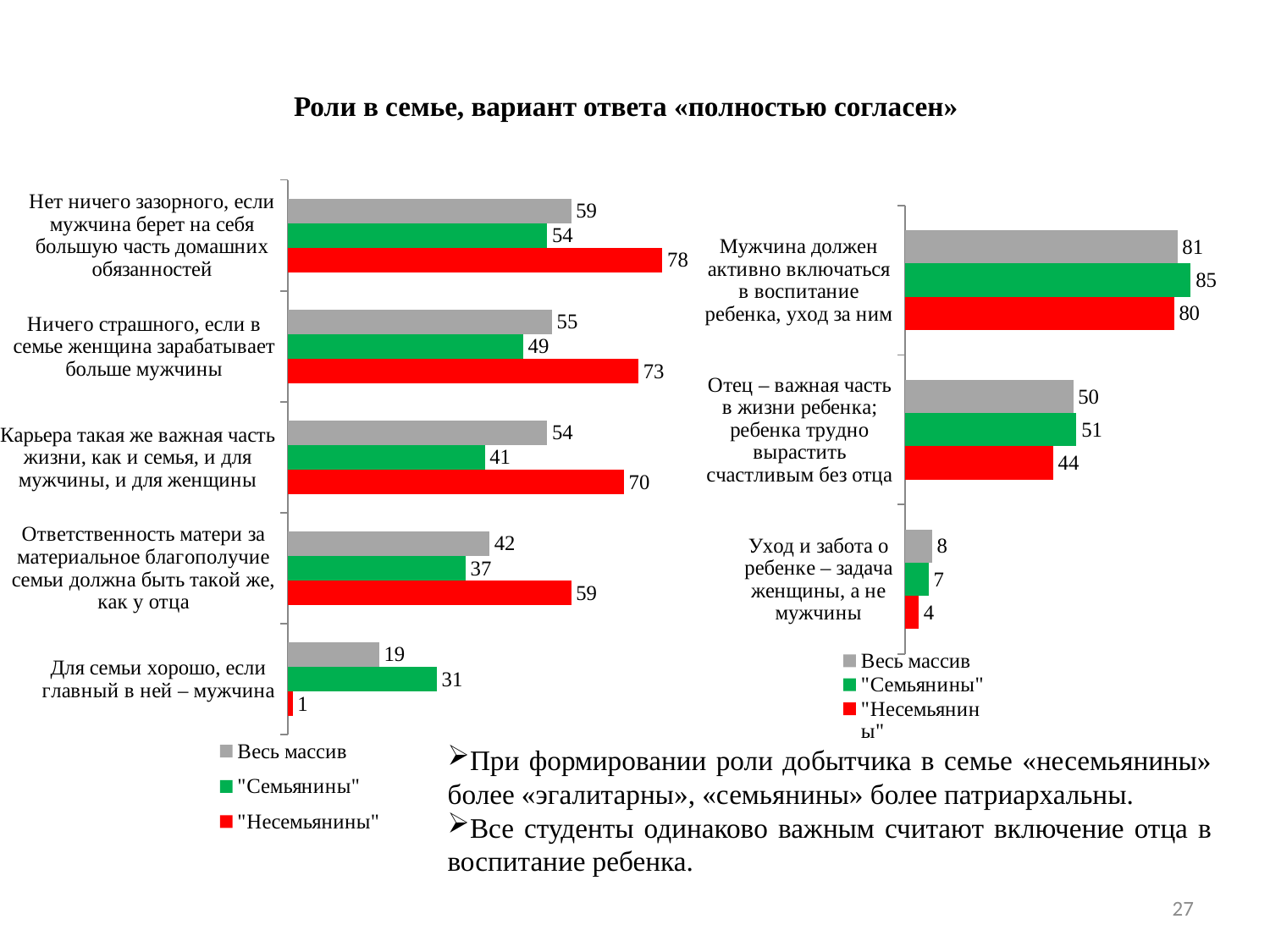
In the left chart, which category has the lowest value for "Несемьянины"? Для семьи хорошо, если главный в ней – мужчина In the left chart, what is the value for "Весь массив" for the statement "Для семьи хорошо, если главный в ней – мужчина"? 19 In the left chart, what is the value for "Несемьянины" for the statement "Нет ничего зазорного, если мужчина берет на себя большую часть домашних обязанностей"? 78 In the left chart, what is the difference between the "Несемьянины" and "Семьянины" values for "Карьера такая же важная часть жизни, как и семья, и для мужчины, и для женщины"? 29 In the left chart, which is larger for "Для семьи хорошо, если главный в ней – мужчина": the value for "Семьянины" or for "Весь массив"? "Семьянины" In the right chart, which category has the highest value for "Весь массив"? Мужчина должен активно включаться в воспитание ребенка, уход за ним In the right chart, what is the value for "Семьянины" for the statement "Мужчина должен активно включаться в воспитание ребенка, уход за ним"? 85 What is the title of the slide's charts? Роли в семье, вариант ответа «полностью согласен» How many categories does the left chart show? 5 What type of chart is the right chart? Bar chart How many series does the legend of the right chart list? 3 In the right chart, which is larger for "Отец – важная часть в жизни ребенка; ребенка трудно вырастить счастливым без отца": the value for "Семьянины" or for "Несемьянины"? "Семьянины"